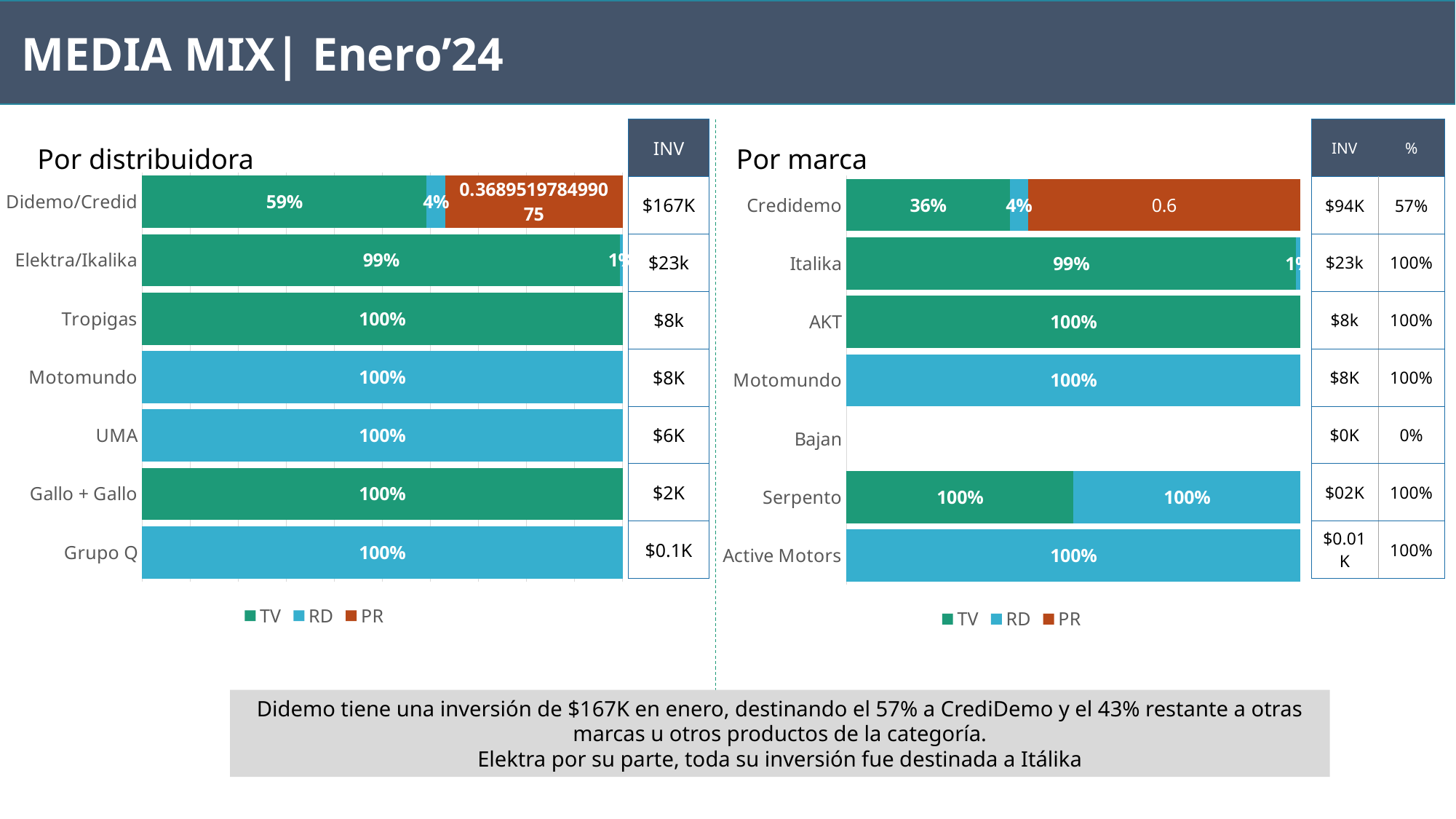
What kind of chart is the 'Por distribuidora' chart? bar chart How many categories are shown in the 'Por marca' chart? 7 What are the legend entries of the 'Por distribuidora' chart? TV, RD, PR How many categories are shown in the 'Por distribuidora' chart? 7 In the 'Por distribuidora' chart, which is larger for Didemo/Credid, the TV share or the RD share? TV In the 'Por marca' chart, what is the TV share for Credidemo? 36% In the 'Por distribuidora' chart, what is the TV share for Tropigas? 100% In the 'Por distribuidora' chart, what is the TV share for Didemo/Credid? 59% How many series does the legend of the 'Por marca' chart list? 3 In the 'Por marca' chart, what value is labelled on the PR segment for Credidemo? 0.6 In the 'Por distribuidora' chart, what is the TV share for Elektra/Ikalika? 99% In the 'Por distribuidora' chart, what is the RD share for Didemo/Credid? 4%